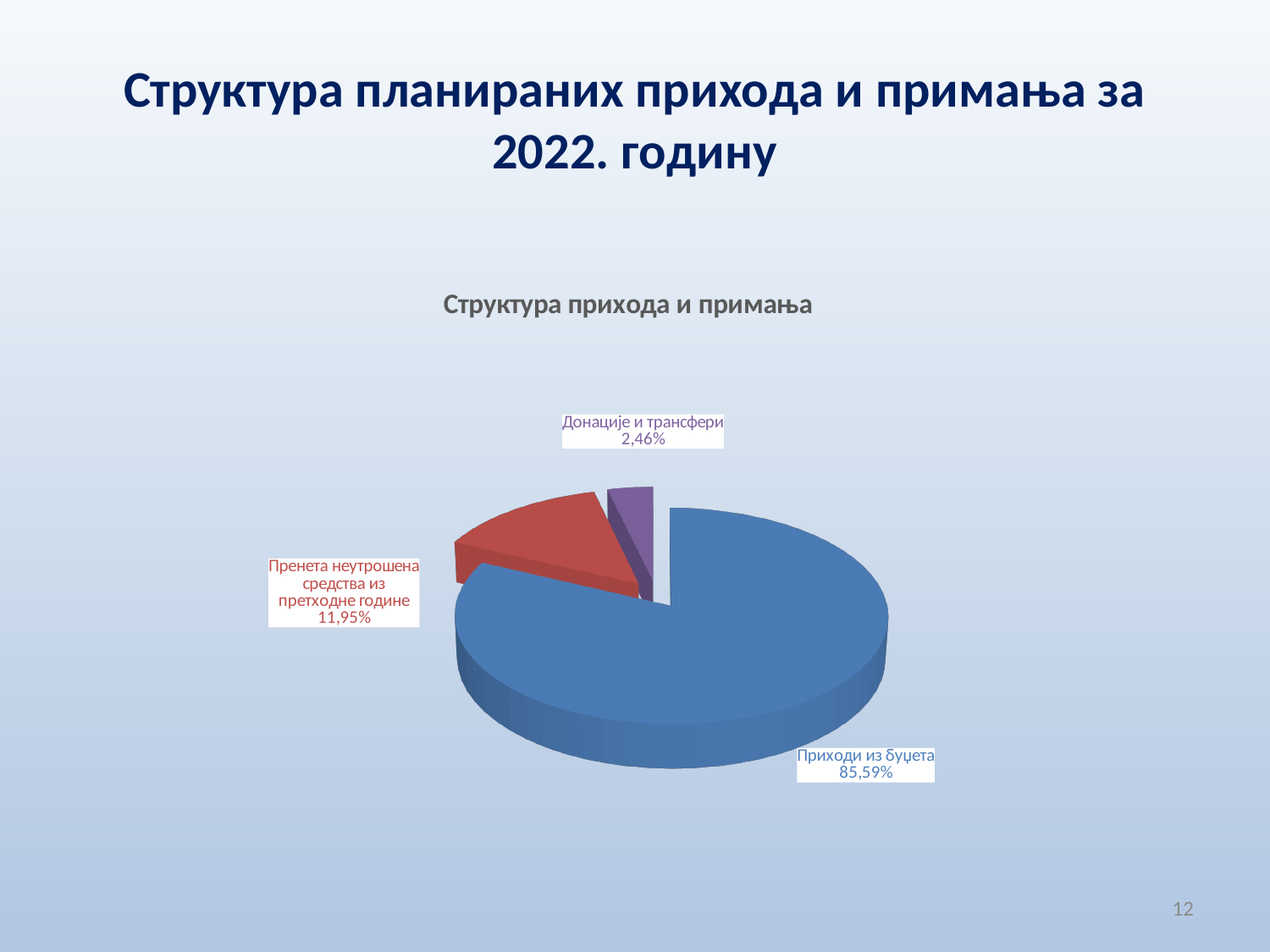
Which category has the smallest slice of the pie? Донације и трансфери Which category has the largest slice of the pie? Приходи из буџета What is the title of the chart? Структура прихода и примања What is the value shown for Донације и трансфери? 2,46% Which is larger: the share for Пренета неутрошена средства из претходне године or the share for Донације и трансфери? Пренета неутрошена средства из претходне године What kind of chart is shown on the slide? Pie chart What is the difference between the shares of Пренета неутрошена средства из претходне године and Донације и трансфери? 9,49% How many slices does the pie chart have? 3 What share of the pie does Приходи из буџета represent? 85,59% What is the value shown for Пренета неутрошена средства из претходне године? 11,95% What colour is the slice for Приходи из буџета? Blue What is the difference between the shares of Приходи из буџета and Пренета неутрошена средства из претходне године? 73,64%